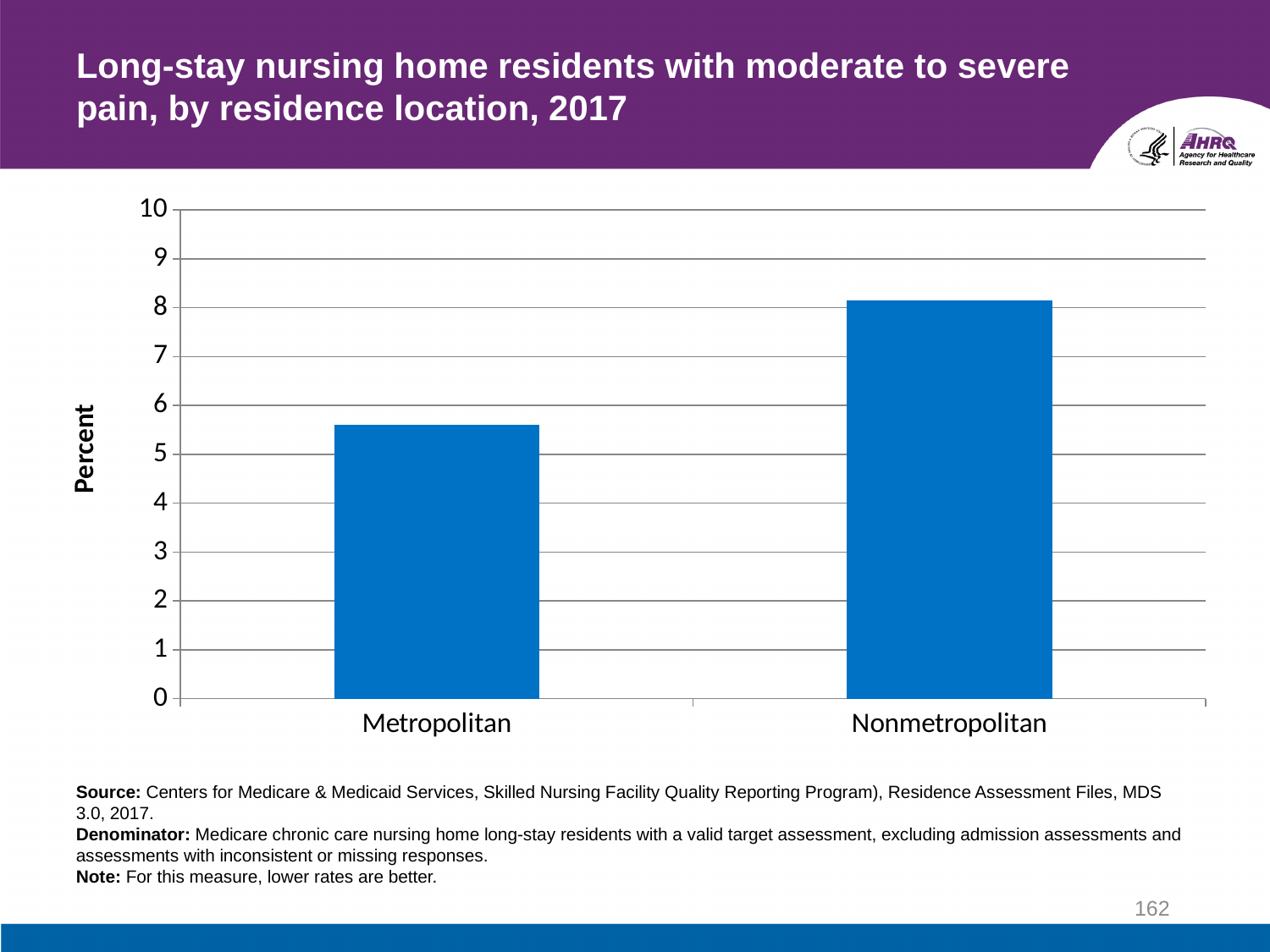
How many categories are shown on the x axis? 2 Is the value for Nonmetropolitan larger or smaller than the value for Metropolitan? larger Is the value for Metropolitan greater or less than 5? greater Which residence location has the higher value? Nonmetropolitan Which residence location has the lower value? Metropolitan What kind of chart is shown on the slide? bar chart Is the value for Metropolitan greater or less than 6? less What is the label on the vertical axis? Percent Is the value for Nonmetropolitan greater or less than 9? less What is the maximum value shown on the vertical axis? 10